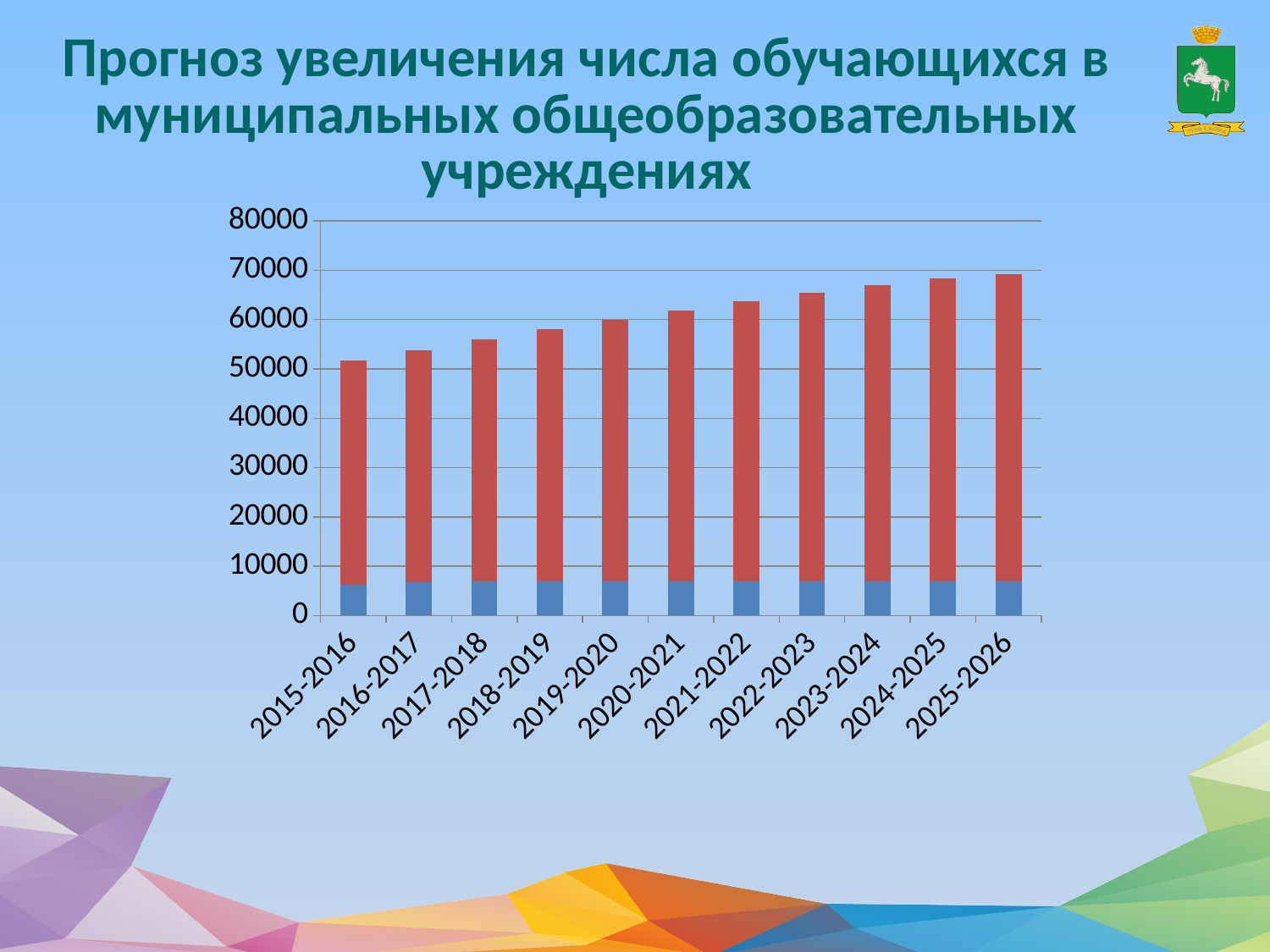
Which academic year has the lowest total bar in the chart? 2015-2016 What kind of chart is shown on the slide? bar chart Is the total value for 2021-2022 greater or less than 60000? greater Do the bar totals rise or fall from 2015-2016 to 2025-2026? rise How many academic years are shown on the x axis of the chart? 11 Is the total value for 2015-2016 greater or less than 50000? greater Which has the larger total bar, 2016-2017 or 2020-2021? 2020-2021 Is the total value for 2023-2024 greater or less than 70000? less Which academic year has the highest total bar in the chart? 2025-2026 What is the title of the slide containing the chart? Прогноз увеличения числа обучающихся в муниципальных общеобразовательных учреждениях